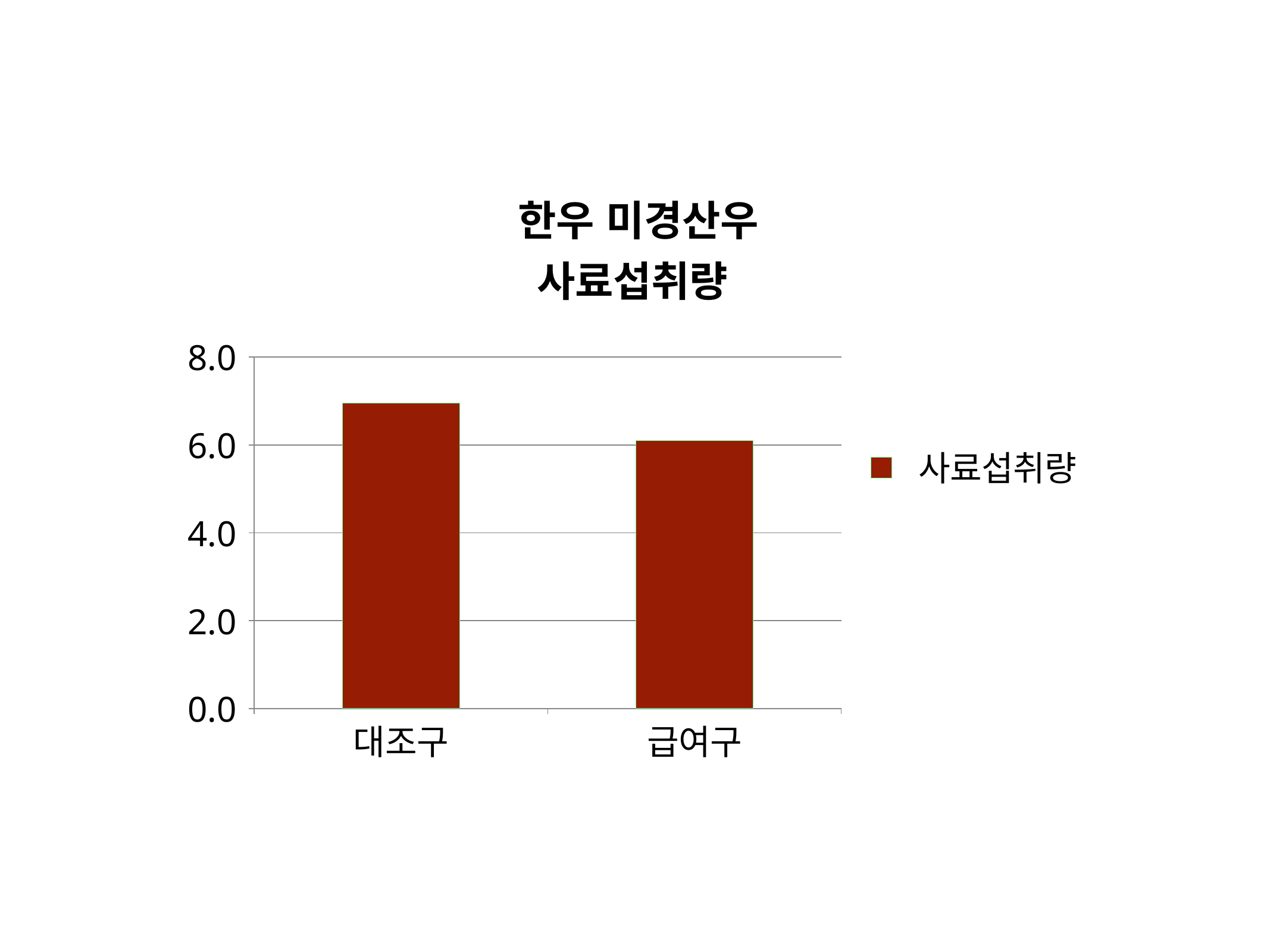
Is the value for 대조구 greater or less than 6.0? greater How many series does the legend list? 1 Is the value for 대조구 greater or less than 8.0? less Which is larger, the value for 대조구 or the value for 급여구? 대조구 What is the title of the chart? 한우 미경산우 사료섭취량 Is the value for 급여구 greater or less than 4.0? greater Which category has the lowest value? 급여구 What series name is shown in the legend? 사료섭취량 What kind of chart is shown on the slide? bar chart How many categories are shown on the x axis? 2 Do the values rise or fall from 대조구 to 급여구? fall Which category has the highest value? 대조구